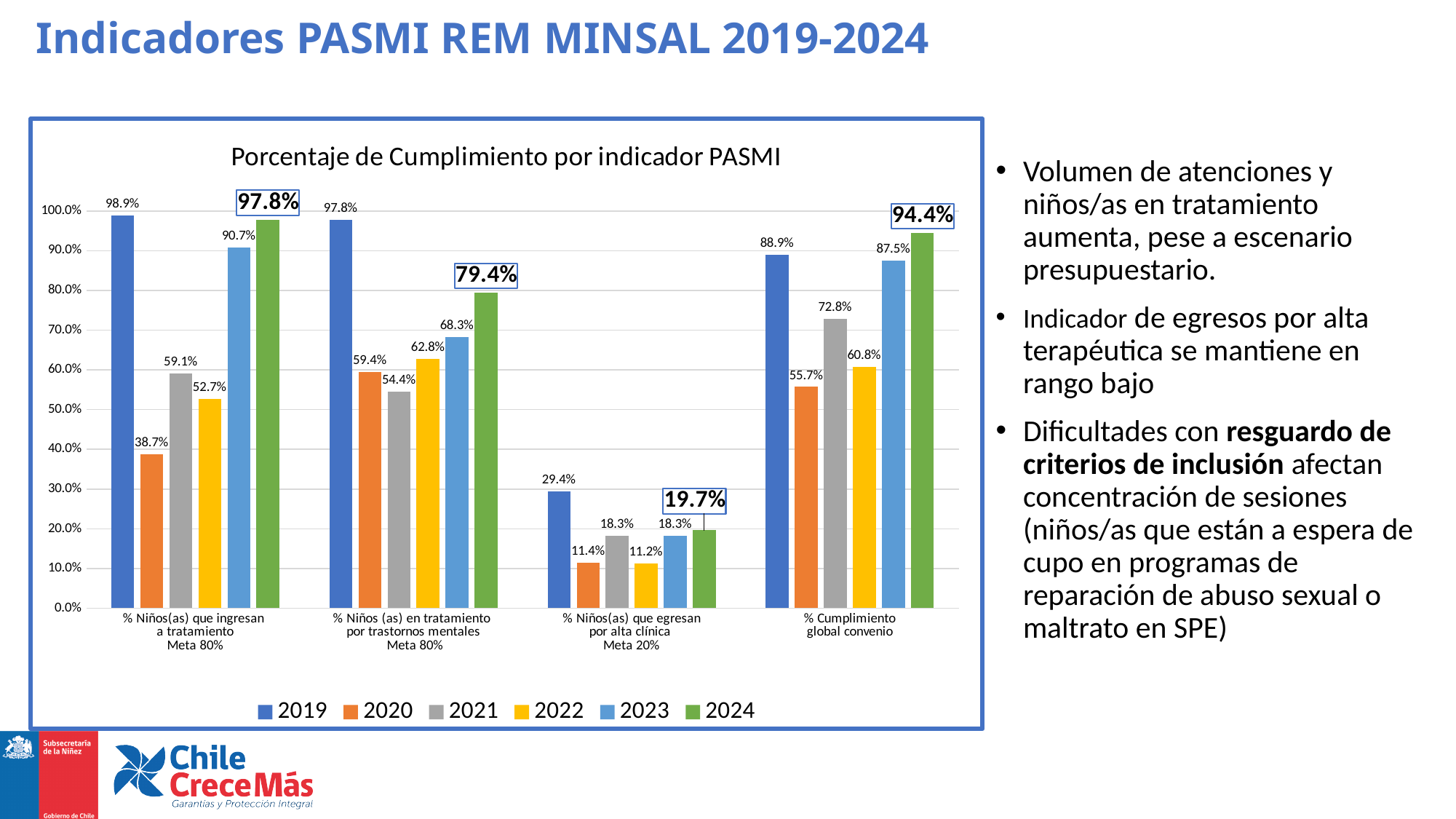
Which year has the highest value in the category '% Cumplimiento global convenio'? 2024 What is the value for 2023 in the category '% Cumplimiento global convenio'? 87.5% What is the value for 2024 in the category '% Niños(as) en tratamiento por trastornos mentales'? 79.4% Which year has the lowest value in the category '% Niños(as) que egresan por alta clínica'? 2022 What is the difference between the 2024 and 2023 values in the category '% Cumplimiento global convenio'? 6.9% What type of chart is shown on the slide? Bar chart How many series does the legend list? 6 What is the value for 2020 in the category '% Niños(as) que ingresan a tratamiento'? 38.7% How many categories are shown on the x axis of the chart? 4 In the category '% Niños(as) en tratamiento por trastornos mentales', which is larger: the 2020 value or the 2021 value? 2020 What is the value for 2019 in the category '% Niños(as) que egresan por alta clínica'? 29.4% Is the value for 2021 in the category '% Niños(as) que ingresan a tratamiento' greater or less than 50.0%? greater